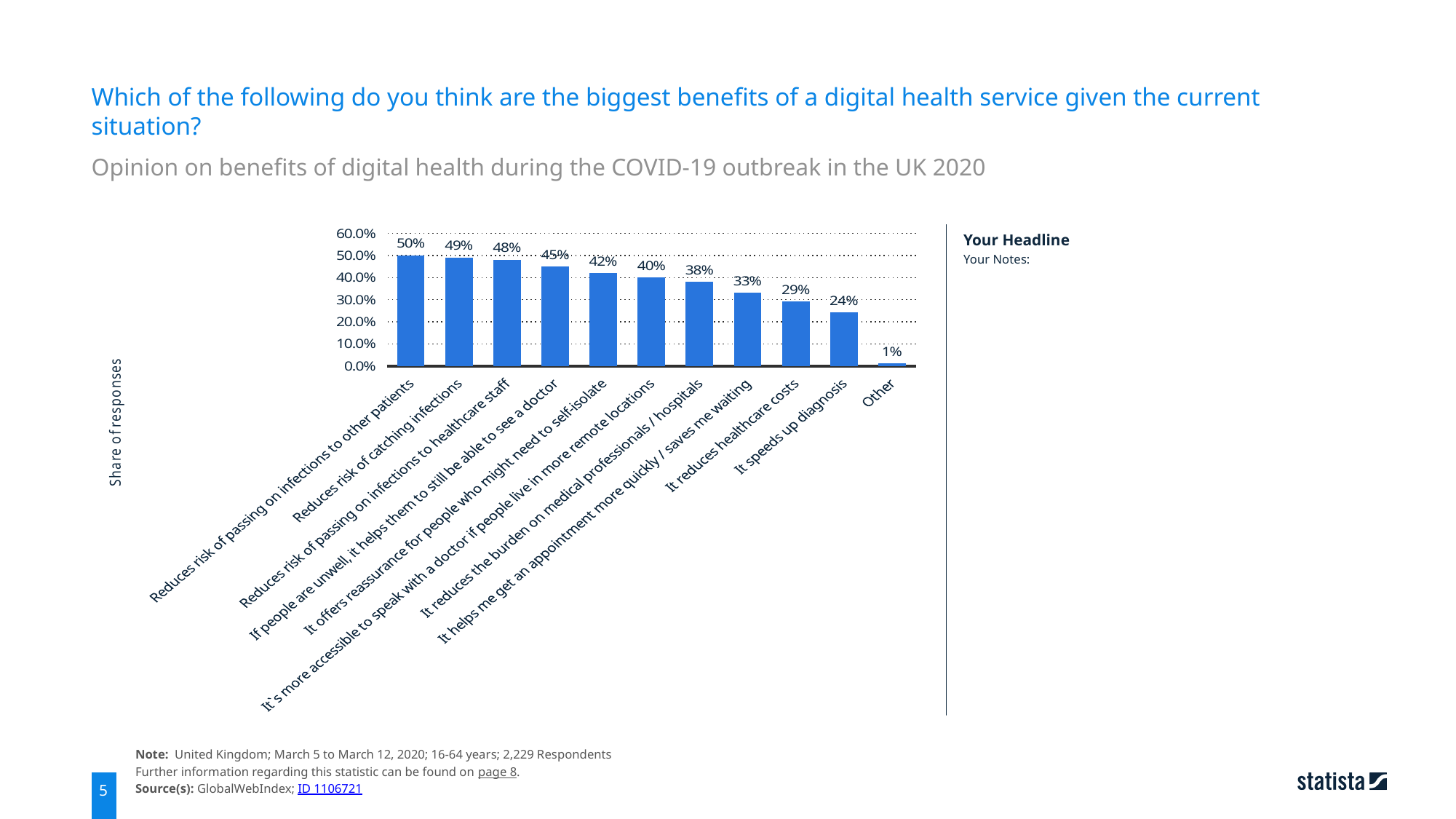
How many categories are shown on the x axis of the chart? 11 What is the difference between the share for "It offers reassurance for people who might need to self-isolate" and the share for "It helps me get an appointment more quickly / saves me waiting"? 9% Is the value for "It's more accessible to speak with a doctor if people live in more remote locations" greater or less than 30.0%? greater What is the label of the vertical axis? Share of responses What is the difference between the share for "Reduces risk of passing on infections to other patients" and the share for "Other"? 49% Which category has the lowest share of responses? Other What kind of chart is shown on the slide? Bar chart What share of responses is shown for "It reduces healthcare costs"? 29% What share of responses is shown for "It speeds up diagnosis"? 24% Which has a larger share of responses: "It reduces the burden on medical professionals / hospitals" or "It speeds up diagnosis"? It reduces the burden on medical professionals / hospitals Which category has the highest share of responses? Reduces risk of passing on infections to other patients What share of responses is shown for "Reduces risk of catching infections"? 49%